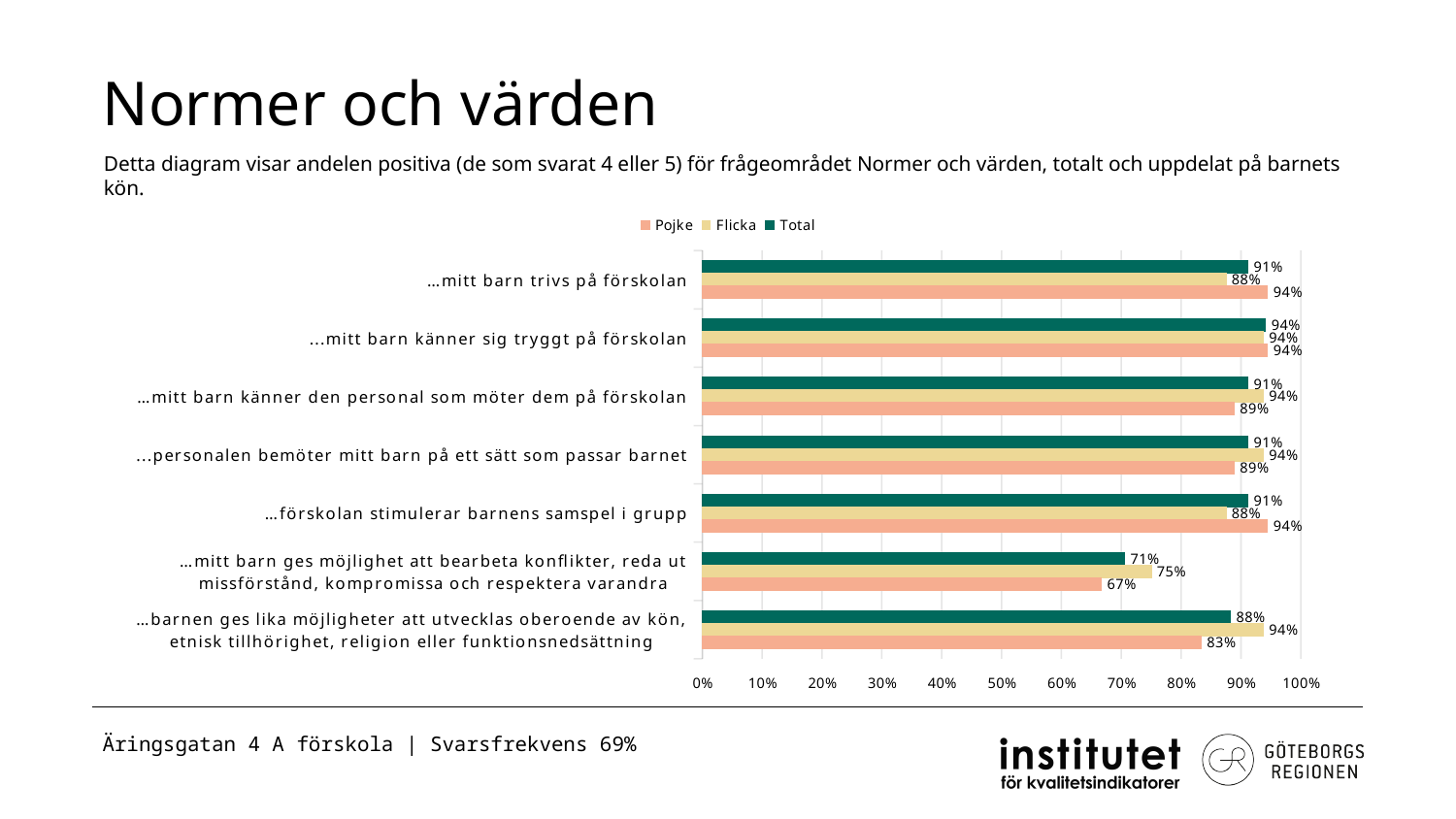
Is the Total value for "…mitt barn ges möjlighet att bearbeta konflikter, reda ut missförstånd, kompromissa och respektera varandra" greater or less than 80%? less How many categories are shown on the y axis of the chart? 7 What is the Total value for "…mitt barn trivs på förskolan"? 91% What is the Pojke value for "…mitt barn ges möjlighet att bearbeta konflikter, reda ut missförstånd, kompromissa och respektera varandra"? 67% What kind of chart is shown on the slide? bar chart Which series is shown in green in the legend? Total How many series does the legend list? 3 What is the Flicka value for "…barnen ges lika möjligheter att utvecklas oberoende av kön, etnisk tillhörighet, religion eller funktionsnedsättning"? 94% What is the difference between the Flicka and Pojke values for "…barnen ges lika möjligheter att utvecklas oberoende av kön, etnisk tillhörighet, religion eller funktionsnedsättning"? 11% Which category has the lowest Total value? …mitt barn ges möjlighet att bearbeta konflikter, reda ut missförstånd, kompromissa och respektera varandra For "…mitt barn trivs på förskolan", which is larger, the Pojke value or the Flicka value? Pojke Which category has the highest Total value? ...mitt barn känner sig tryggt på förskolan